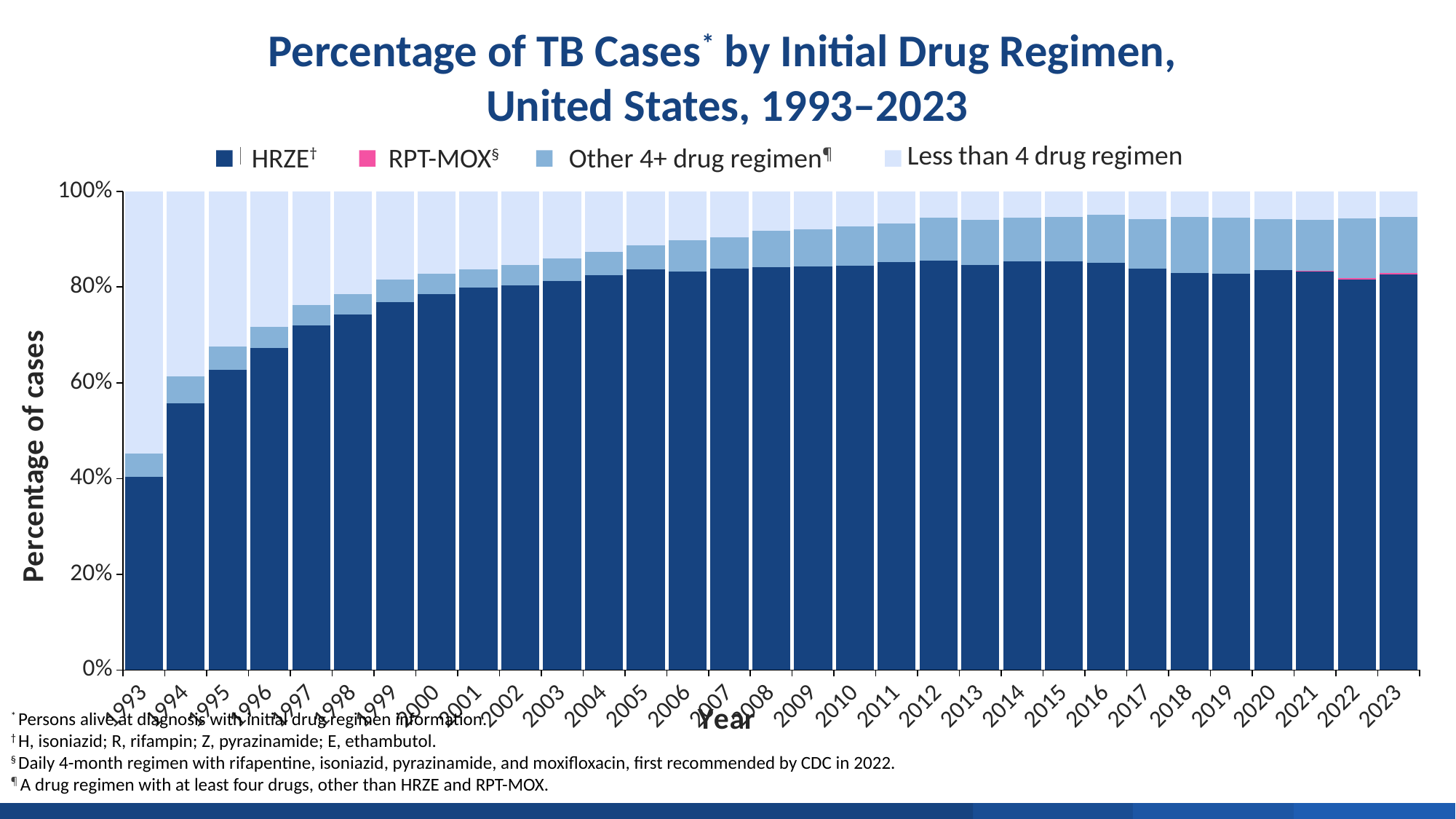
Is the HRZE value for 2023 greater or less than 80%? greater Which year has the lowest HRZE percentage? 1993 Which year has the largest share for the Less than 4 drug regimen series? 1993 Does the HRZE percentage rise or fall from 1993 to 2000? Rise What is the label of the y axis? Percentage of cases What kind of chart is shown on the slide? Stacked bar chart Is the HRZE value for 1997 greater or less than 80%? less Is the HRZE value for 1994 greater or less than 60%? less What is the total of each stacked bar? 100% Which year has a larger HRZE percentage, 1993 or 1994? 1994 How many years are shown along the x axis? 31 How many series does the legend list? 4